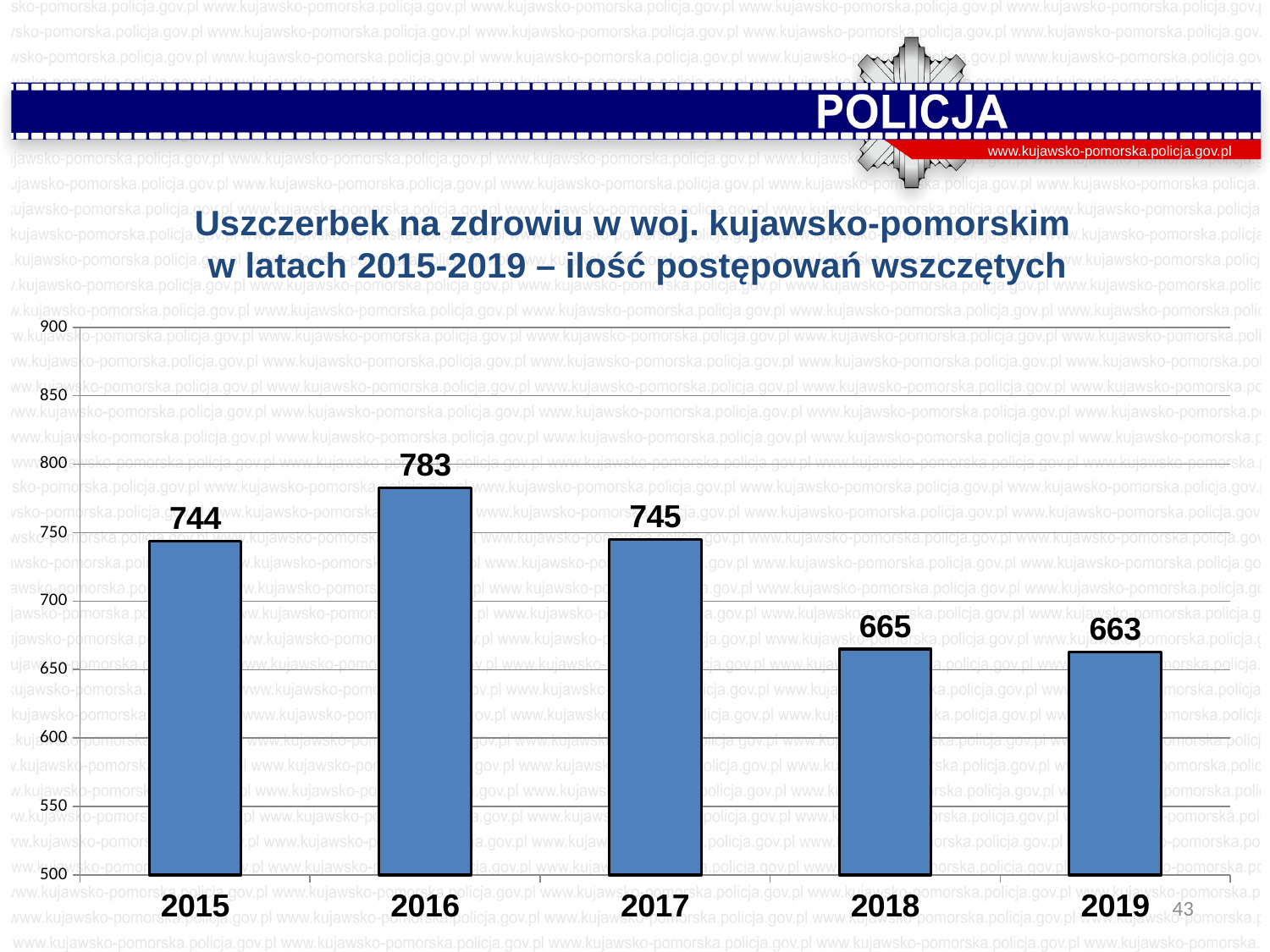
Which year has the highest value? 2016 What is the difference between the values for 2016 and 2018? 118 How many years are shown on the x axis? 5 Is the value for 2018 greater or less than 700? less What is the difference between the values for 2017 and 2015? 1 What kind of chart is shown on the slide? bar chart Which is larger, the value for 2016 or the value for 2017? 2016 What is the value for 2015? 744 What is the value for 2019? 663 Which year has the lowest value? 2019 What is the value for 2016? 783 Do the values rise or fall from 2017 to 2019? fall